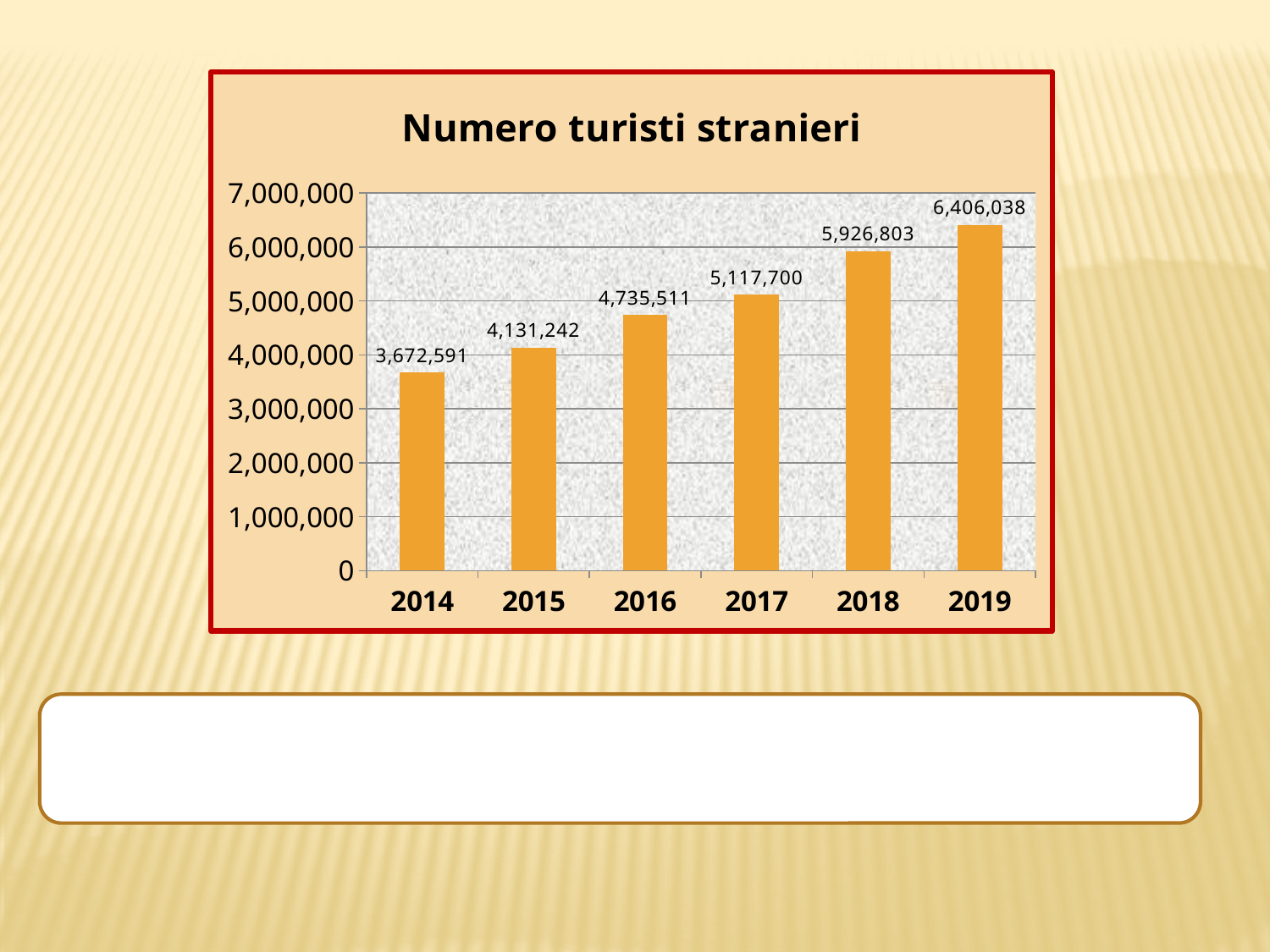
What is the value for 2014? 3,672,591 What is the difference between the values for 2018 and 2017? 809,103 Which year has the lowest value? 2014 What is the value for 2018? 5,926,803 What is the difference between the values for 2019 and 2014? 2,733,447 What is the value for 2016? 4,735,511 How many years are shown on the x axis? 6 Which year has the highest value? 2019 Is the value for 2017 greater or less than 5,000,000? greater What kind of chart is shown? bar chart Which is larger, the value for 2015 or the value for 2017? 2017 Do the values rise or fall from 2014 to 2019? rise